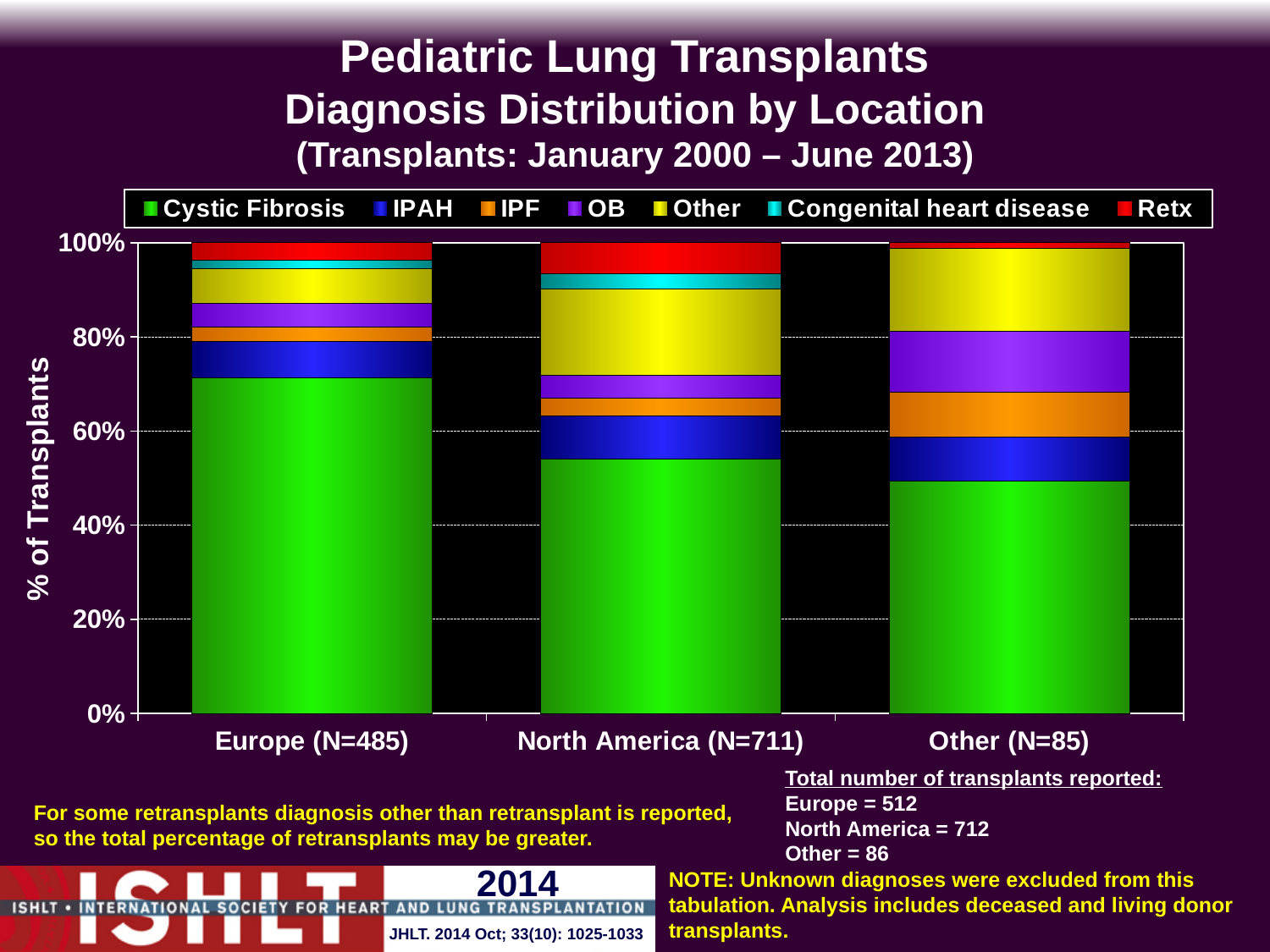
How many location categories are shown on the x axis? 3 What does each stacked bar total on the y axis? 100% Is the Cystic Fibrosis share for Other (N=85) greater or less than 60%? less Is the 'Other' diagnosis segment larger for Other (N=85) or for Europe (N=485)? Other (N=85) Is the Cystic Fibrosis segment larger for Europe (N=485) or for North America (N=711)? Europe (N=485) Which location has the largest Cystic Fibrosis share of transplants? Europe (N=485) Is the Cystic Fibrosis share for Europe (N=485) greater or less than 60%? greater How many diagnosis series does the legend list? 7 What kind of chart is shown on the slide? Stacked bar chart What is the label on the y axis of the chart? % of Transplants Is the Cystic Fibrosis share for North America (N=711) greater or less than 40%? greater What is the N value shown in the category label for North America? 711